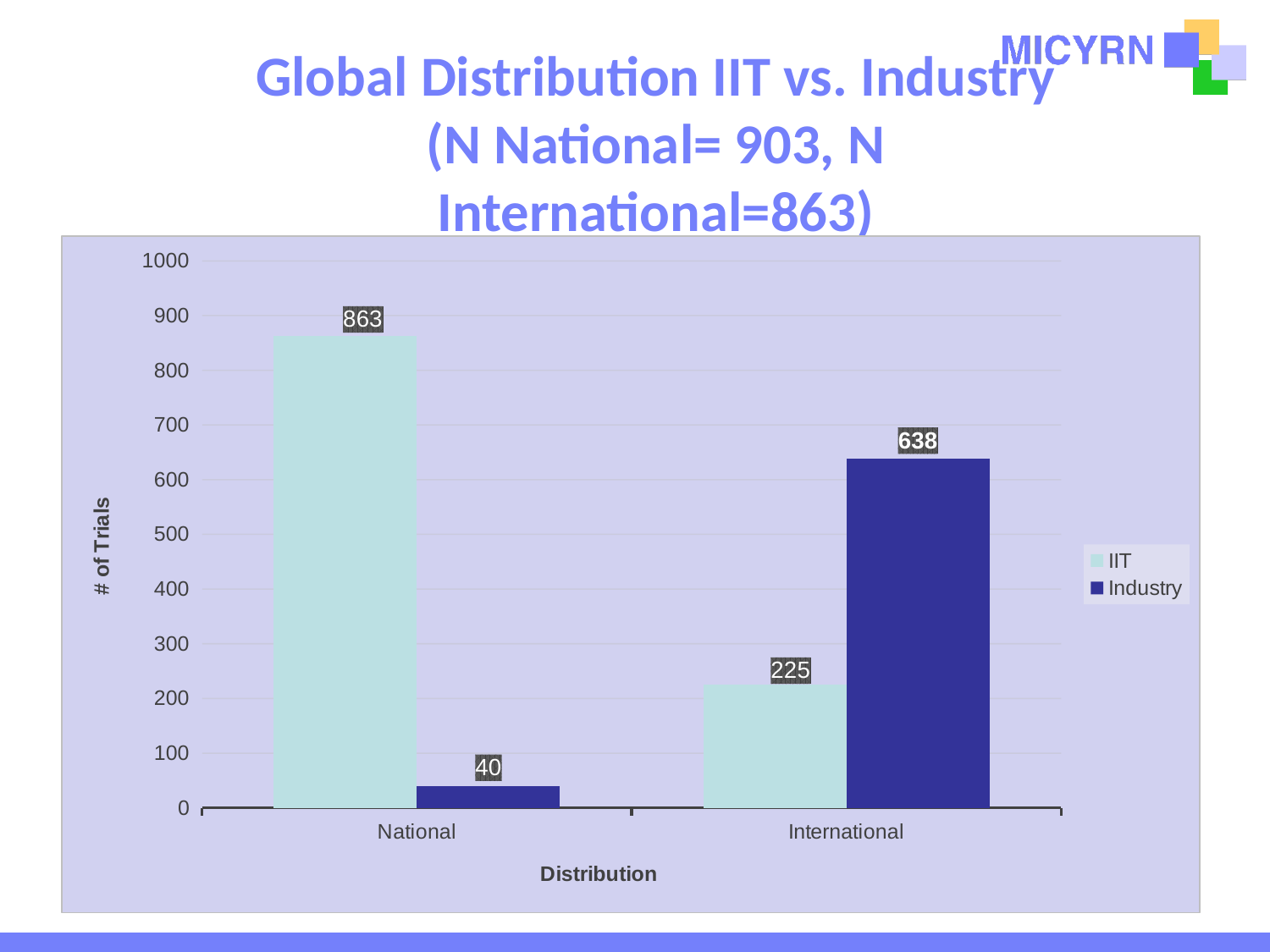
What is the difference between the Industry and IIT values for International? 413 Which is larger for International, IIT or Industry? Industry Which category has the lowest Industry value? National What is the label of the y axis? # of Trials What is the difference between the IIT and Industry values for National? 823 What is the IIT value for National? 863 What is the IIT value for International? 225 What is the Industry value for National? 40 Which category has the highest IIT value? National What kind of chart is shown? Bar chart How many series does the legend list? 2 What is the Industry value for International? 638